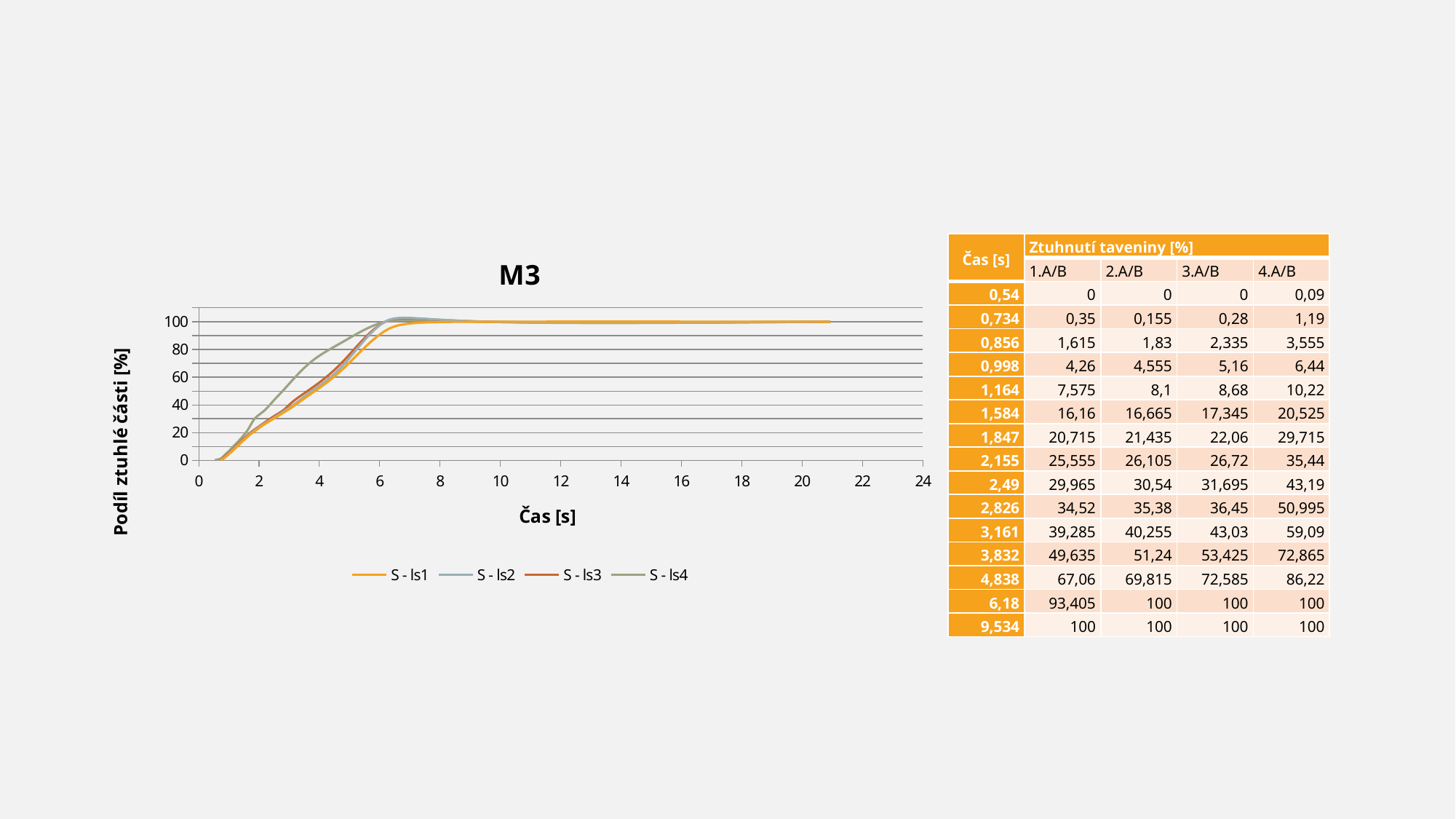
Is the value of S - ls1 at 2 s greater or less than 60? less Is the value of S - ls2 at 10 s greater or less than 80? greater Do the values of the series S - ls1 rise or fall as time increases from 0 to 6 s? rise What is the highest tick value shown on the x axis of the chart? 24 What is the title of the chart? M3 What kind of chart is shown on the slide? line chart Is the value of S - ls4 at 4 s greater or less than 60? greater At 4 s, which series has the larger value, S - ls4 or S - ls1? S - ls4 What is the label of the x axis of the chart? Čas [s] How many series does the chart legend list? 4